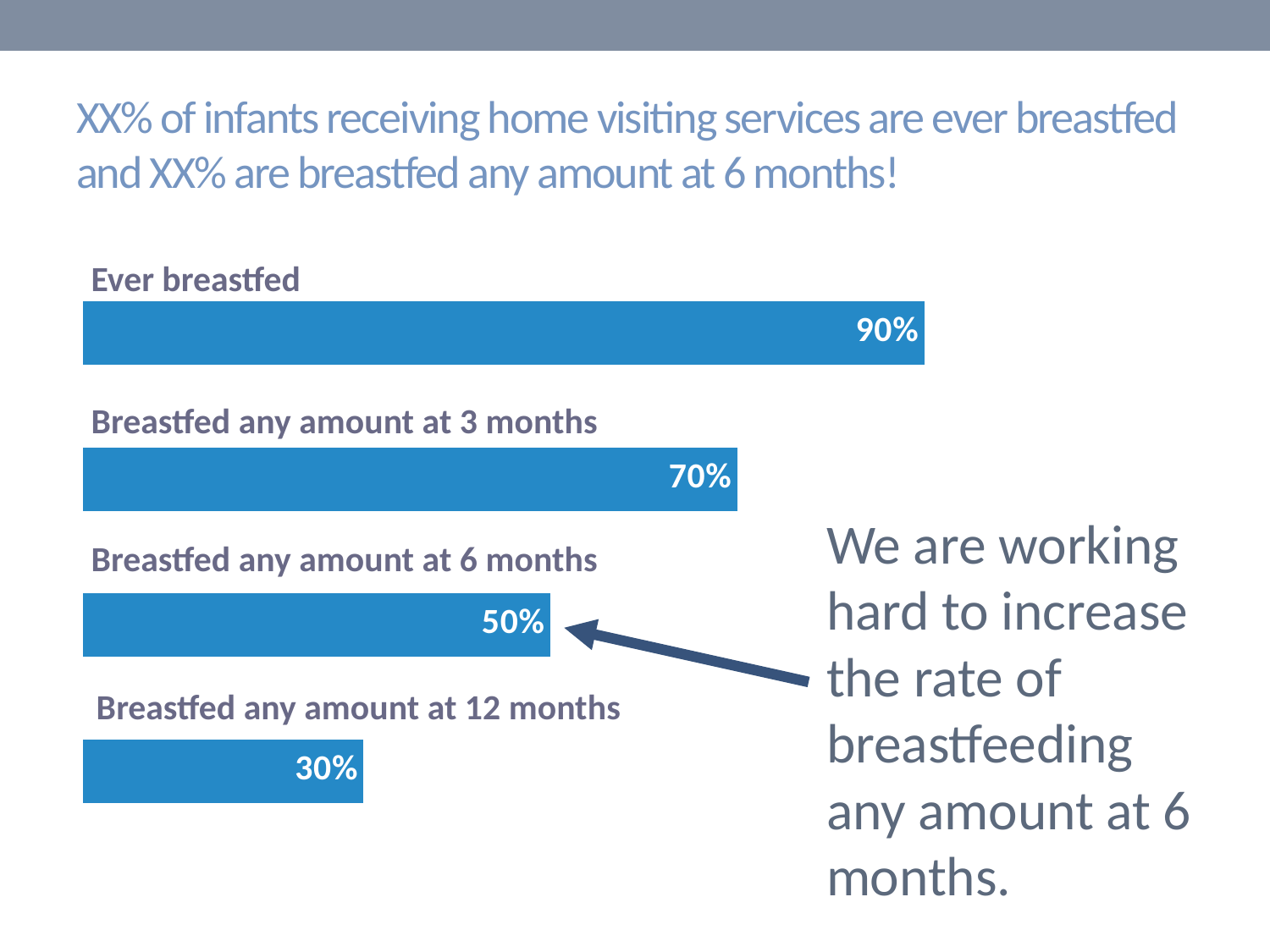
How many categories are shown in the chart? 4 What is the difference between the value for Breastfed any amount at 3 months and the value for Breastfed any amount at 12 months? 40% Which category has the lowest value? Breastfed any amount at 12 months What is the value for Ever breastfed? 90% Which is larger, the value for Breastfed any amount at 3 months or the value for Breastfed any amount at 6 months? Breastfed any amount at 3 months What kind of chart is shown on the slide? Bar chart What is the difference between the value for Ever breastfed and the value for Breastfed any amount at 6 months? 40% Which category has the highest value? Ever breastfed Which bar does the arrow on the slide point to? Breastfed any amount at 6 months What is the value for Breastfed any amount at 6 months? 50% What is the value for Breastfed any amount at 12 months? 30% What is the value for Breastfed any amount at 3 months? 70%